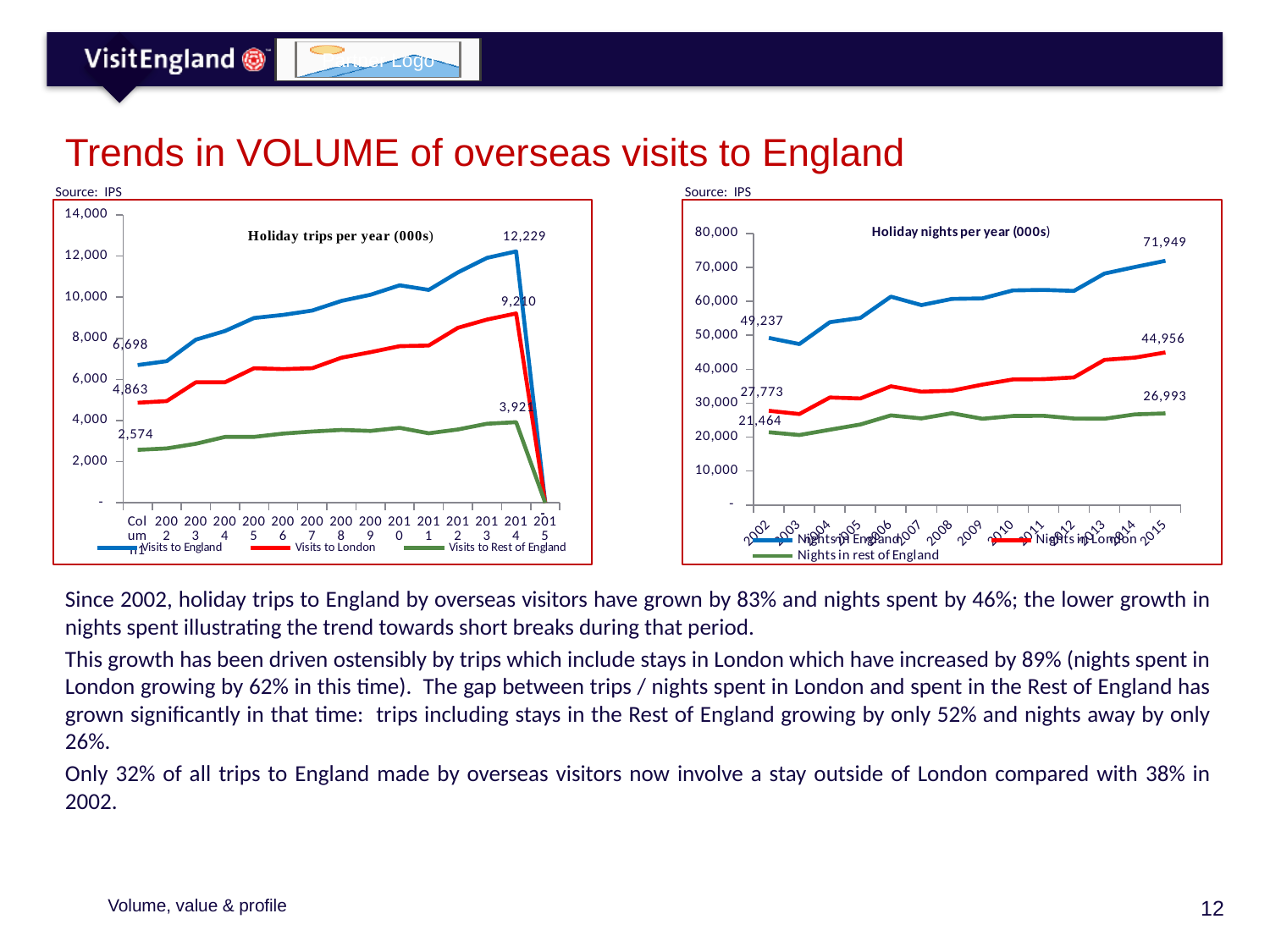
In the 'Holiday nights per year (000s)' chart, what is the value for Nights in rest of England in 2015? 26,993 In the 'Holiday nights per year (000s)' chart, how many years are shown on the x axis? 14 In the 'Holiday nights per year (000s)' chart, do Nights in England rise or fall overall from 2002 to 2015? rise In the 'Holiday nights per year (000s)' chart, what is the value for Nights in England in 2015? 71,949 In the 'Holiday nights per year (000s)' chart, by how much did Nights in England increase from 2002 to 2015? 22,712 In the 'Holiday nights per year (000s)' chart, what is the value for Nights in London in 2002? 27,773 What kind of chart is the 'Holiday nights per year (000s)' chart on the right? line chart In the 'Holiday trips per year (000s)' chart, what is the first labelled value for Visits to Rest of England? 2,574 How many series does the legend of the 'Holiday trips per year (000s)' chart on the left list? 3 In the 'Holiday nights per year (000s)' chart, what is the difference between Nights in London and Nights in rest of England in 2015? 17,963 In the 'Holiday trips per year (000s)' chart, what is the highest labelled value for Visits to England? 12,229 In the 'Holiday nights per year (000s)' chart, which is larger in 2015: Nights in London or Nights in rest of England? Nights in London